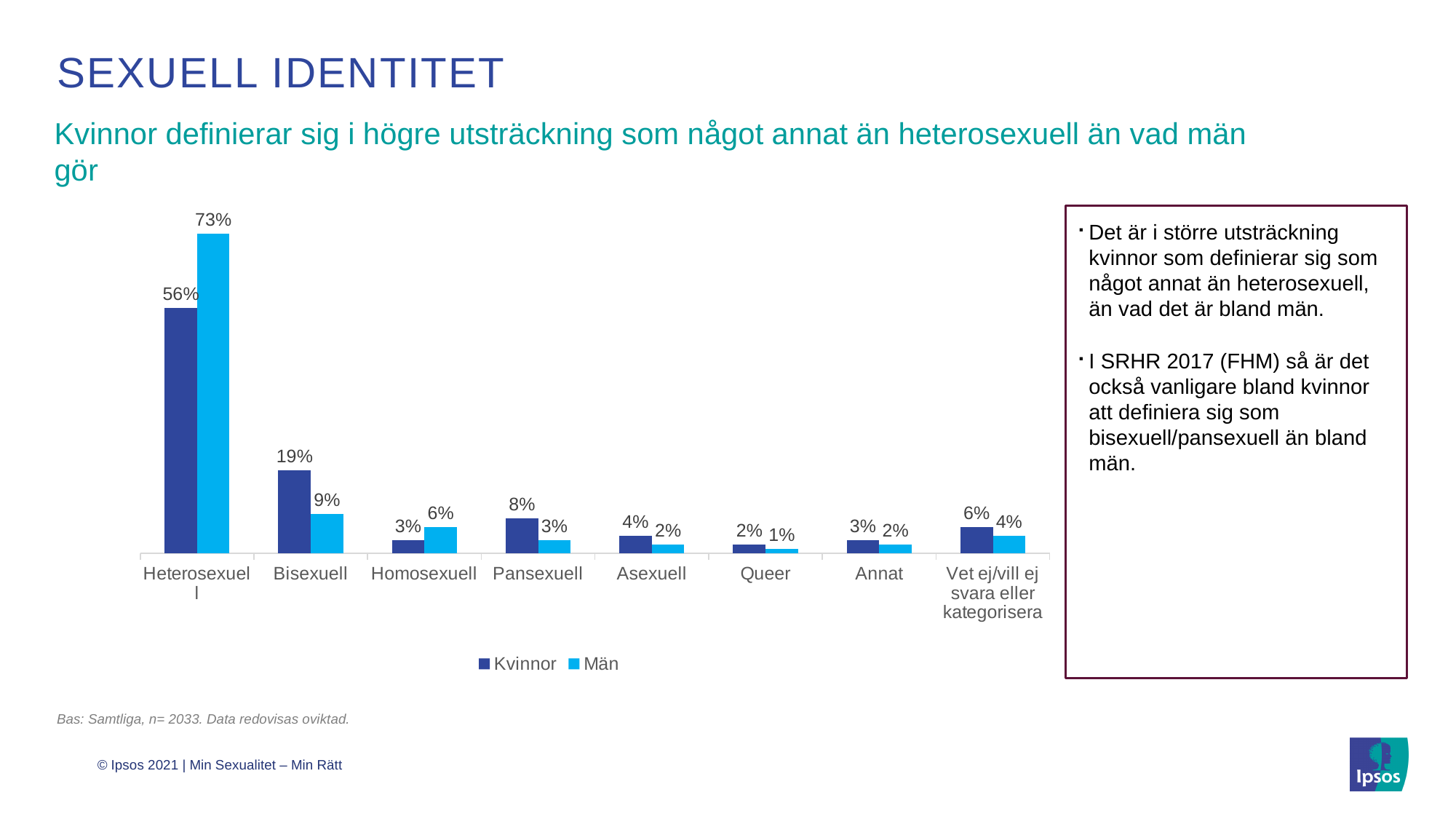
Which category has the highest value for Män? Heterosexuell What is the value for Kvinnor in the Pansexuell category? 8% What are the two series named in the legend? Kvinnor and Män How many categories are shown on the x axis? 8 What is the value for Män in the Bisexuell category? 9% Which category has the lowest value for Män? Queer What kind of chart is shown on the slide? Bar chart What is the difference between Kvinnor and Män in the Bisexuell category? 10% What is the value for Kvinnor in the Heterosexuell category? 56% How many series does the legend list? 2 Which is larger in the Homosexuell category, Kvinnor or Män? Män What is the difference between Män and Kvinnor in the Heterosexuell category? 17%